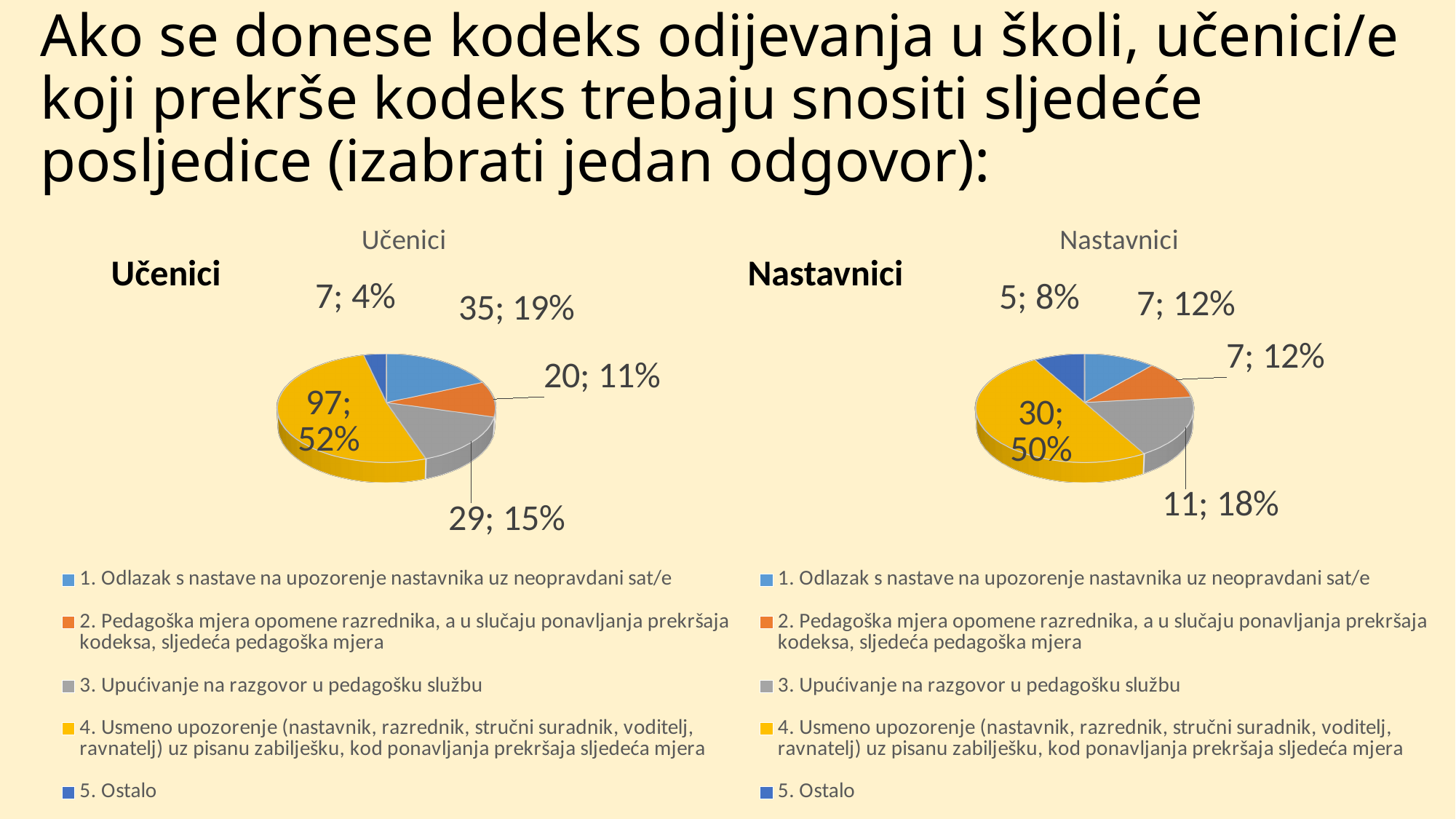
What type of chart is used for the Učenici data? Pie chart In the Nastavnici chart, what is the difference in count between option 4 (30) and option 3 (11)? 19 In the Nastavnici chart, which option has the largest slice? 4. Usmeno upozorenje (nastavnik, razrednik, stručni suradnik, voditelj, ravnatelj) uz pisanu zabilješku, kod ponavljanja prekršaja sljedeća mjera In the Učenici chart, what is the difference in count between option 1 (35) and option 3 (29)? 6 In the Učenici chart, what value is shown for option 4 (Usmeno upozorenje ... uz pisanu zabilješku)? 97; 52% In the Nastavnici chart, what share of the pie does option 5 (Ostalo) take? 8% How many slices does the Nastavnici pie chart have? 5 What colour is the slice for option 4 in both pie charts? Yellow In the Nastavnici chart, what value is shown for option 3 (Upućivanje na razgovor u pedagošku službu)? 11; 18% In the Učenici chart, which option has the smallest slice? 5. Ostalo In the Učenici chart, what value is shown for option 5 (Ostalo)? 7; 4% In the Učenici chart, which is larger: the slice for option 1 or the slice for option 2? Option 1